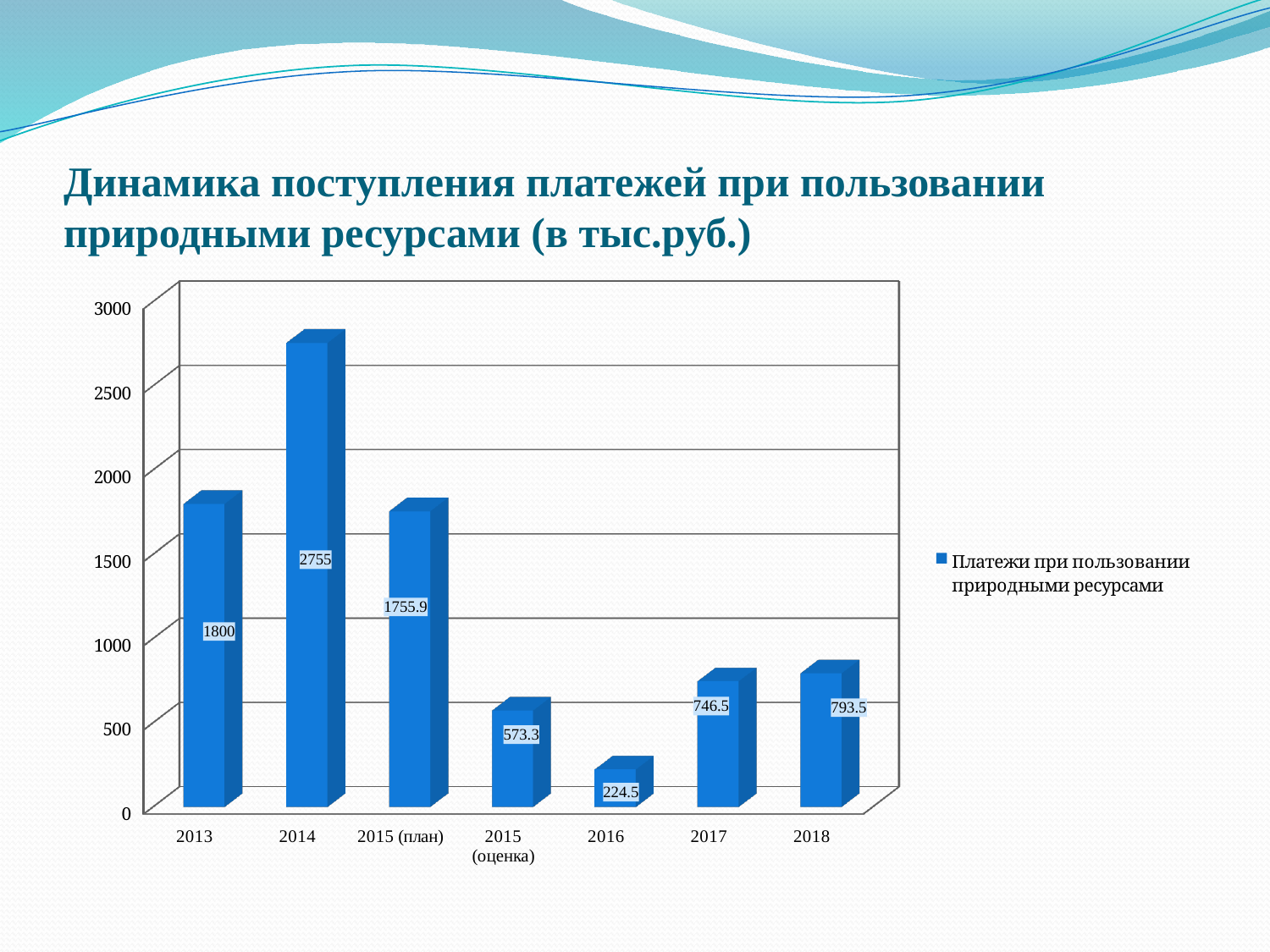
Which category has the lowest value? 2016 How many categories are shown on the x axis? 7 Which category has the highest value? 2014 What kind of chart is shown on the slide? bar chart What is the value for 2015 (план)? 1755.9 What is the value for 2014? 2755 Which is larger, the value for 2015 (оценка) or the value for 2017? 2017 What is the difference between the values for 2018 and 2017? 47 What is the value for 2016? 224.5 How many series does the legend list? 1 What is the value for 2018? 793.5 What is the difference between the values for 2014 and 2013? 955